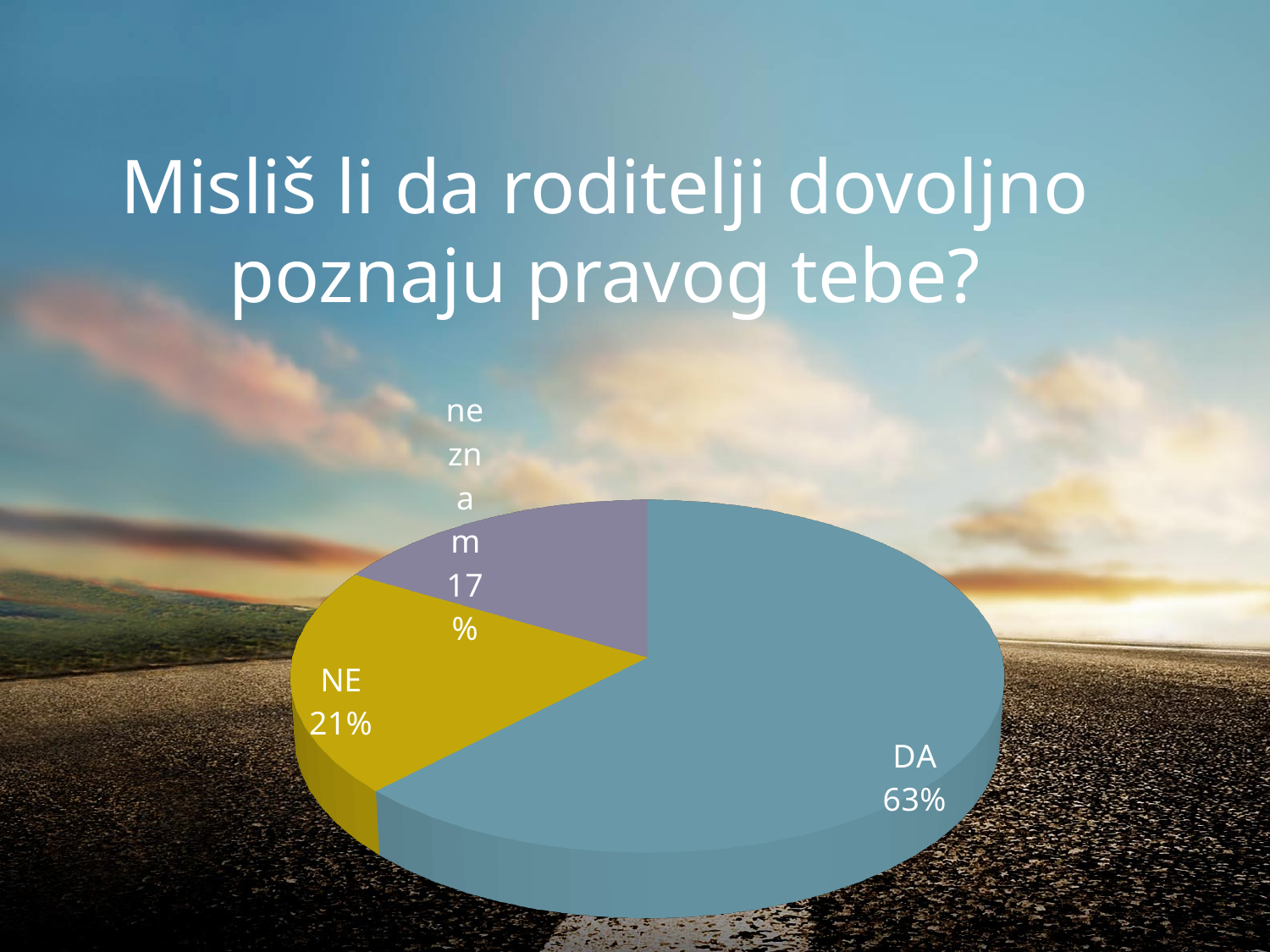
What is the difference in percentage points between DA and NE? 42 What is the difference in percentage points between NE and ne znam? 4 What is the title of the chart on the slide? Misliš li da roditelji dovoljno poznaju pravog tebe? Which is larger, the share for NE or the share for ne znam? NE Which answer has the largest share of the pie? DA How many slices does the pie chart have? 3 What percentage of respondents answered NE? 21% What colour is the DA slice of the pie? blue What kind of chart is shown on the slide? pie chart What percentage of respondents answered ne znam? 17% What percentage of respondents answered DA? 63% Which answer has the smallest share of the pie? ne znam